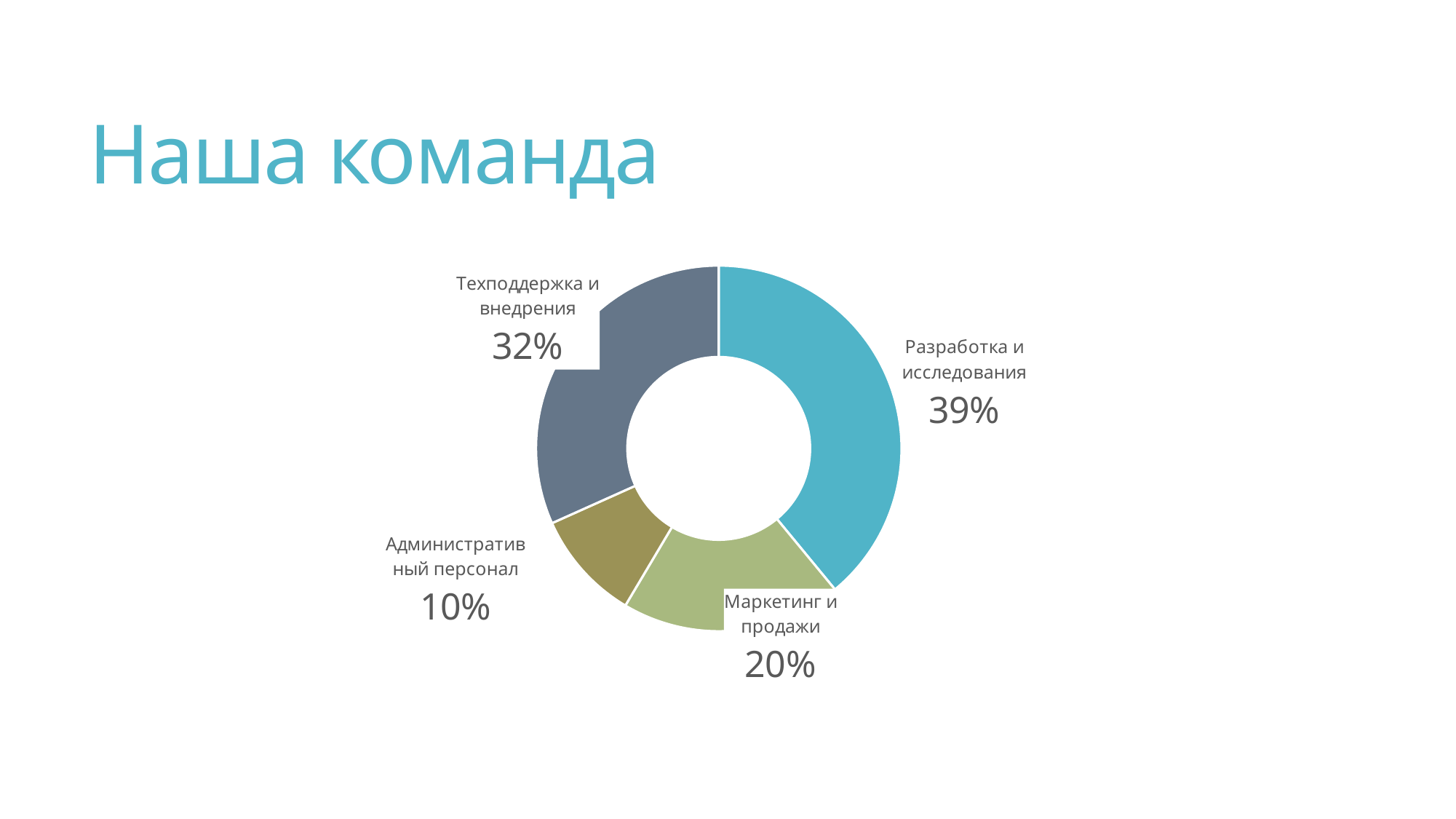
What share of the team is Разработка и исследования? 39% Which category has the smallest share of the team? Административный персонал What kind of chart is shown on the slide? Doughnut (pie) chart What is the title of the slide containing the chart? Наша команда Which category has the largest share of the team? Разработка и исследования What share of the team is Административный персонал? 10% What share of the team is Техподдержка и внедрения? 32% What is the difference in percentage points between Маркетинг и продажи and Административный персонал? 10 What share of the team is Маркетинг и продажи? 20% Which is larger: the share for Техподдержка и внедрения or the share for Маркетинг и продажи? Техподдержка и внедрения How many categories does the chart show? 4 What is the difference in percentage points between Разработка и исследования and Техподдержка и внедрения? 7